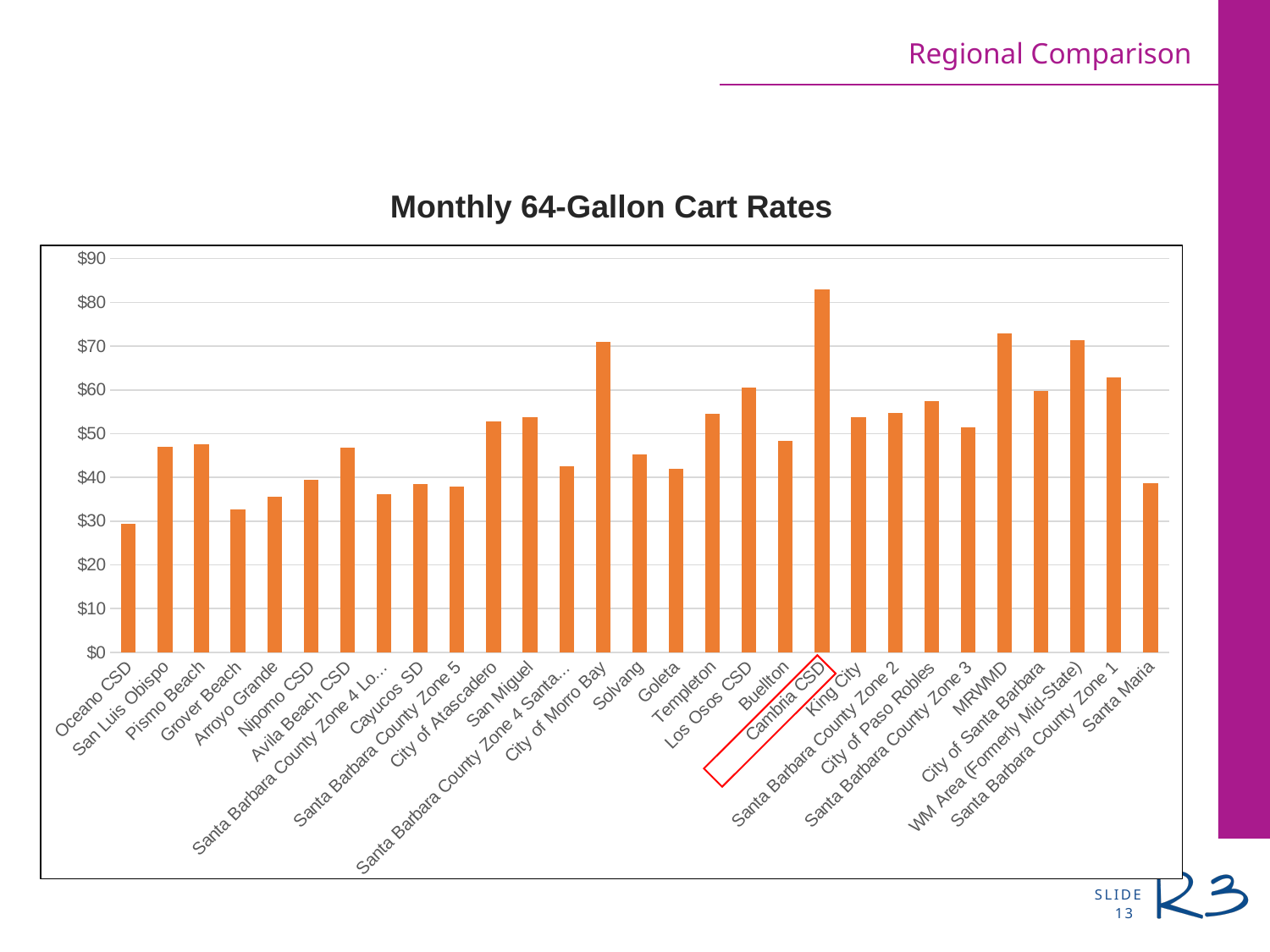
Which has a higher monthly rate, Pismo Beach or Grover Beach? Pismo Beach Which category has the highest monthly 64-gallon cart rate? Cambria CSD Is the value for Buellton greater or less than $50? less Is the value for Santa Maria greater or less than $40? less Which category has the lowest monthly 64-gallon cart rate? Oceano CSD Which has a higher monthly rate, Cambria CSD or City of Morro Bay? Cambria CSD What is the title of the chart? Monthly 64-Gallon Cart Rates Is the value for Cambria CSD greater or less than $80? greater What kind of chart is shown on the slide? bar chart Which category label is outlined with a red box on the x axis? Cambria CSD